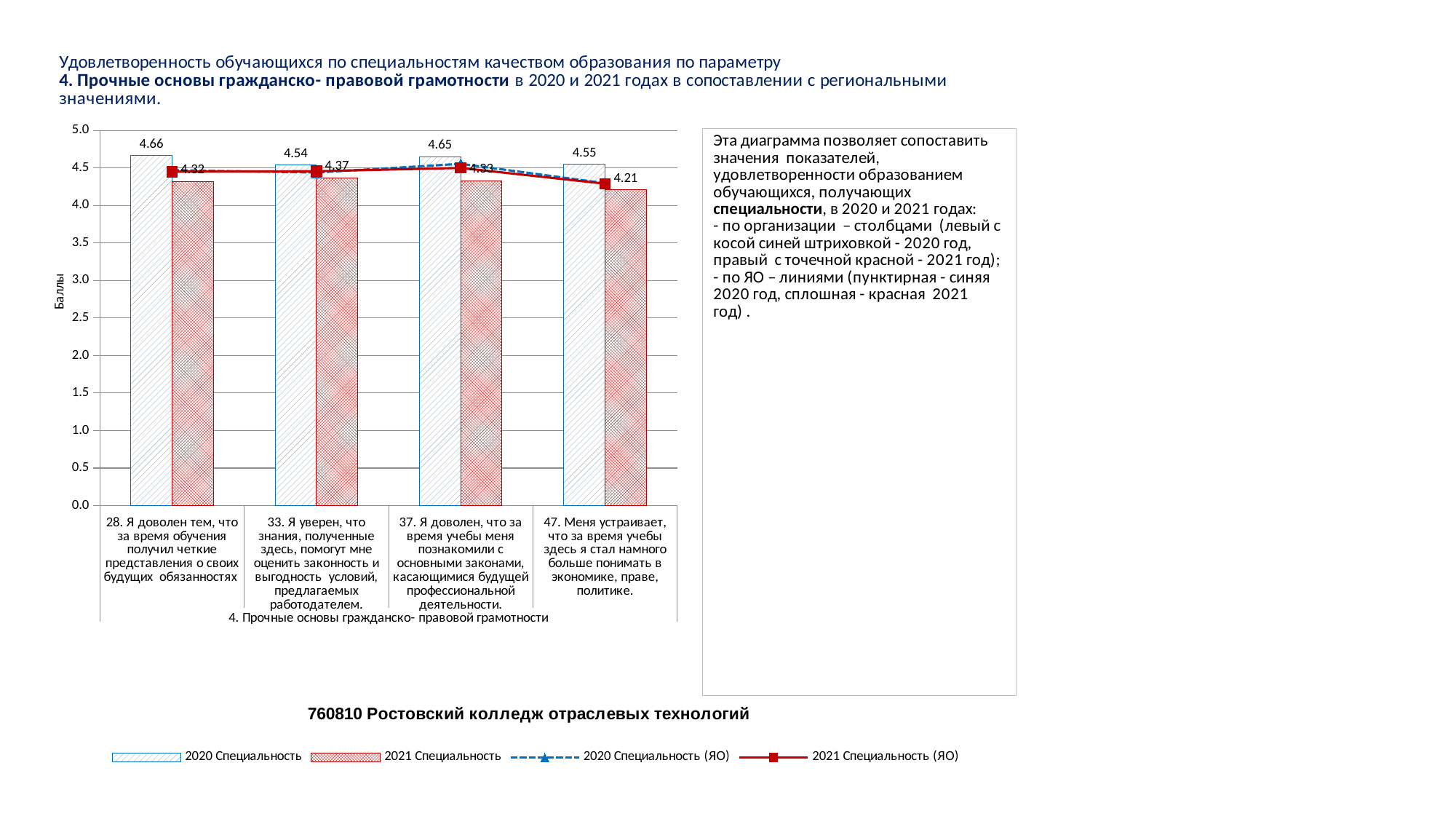
How many series does the legend list? 4 Is the 2021 Специальность bar for item 47 greater or less than 4.5? less Which item has the lowest 2021 Специальность bar? 47. Меня устраивает, что за время учебы здесь я стал намного больше понимать в экономике, праве, политике. What is the value of the 2020 Специальность bar for item 37 (Я доволен, что за время учебы меня познакомили с основными законами)? 4.65 What is the value of the 2020 Специальность bar for item 28 (Я доволен тем, что за время обучения получил четкие представления о своих будущих обязанностях)? 4.66 What is the value of the 2021 Специальность bar for item 47 (Меня устраивает, что за время учебы здесь я стал намного больше понимать в экономике, праве, политике)? 4.21 How many survey items (categories) are shown on the x axis? 4 For item 47, which bar is larger: 2020 Специальность or 2021 Специальность? 2020 Специальность What is the value of the 2021 Специальность bar for item 33 (Я уверен, что знания, полученные здесь, помогут мне оценить законность и выгодность условий, предлагаемых работодателем)? 4.37 What is the difference between the 2020 and 2021 Специальность bars for item 33? 0.17 What is the difference between the 2020 and 2021 Специальность bars for item 28? 0.34 What is the label of the vertical axis? Баллы